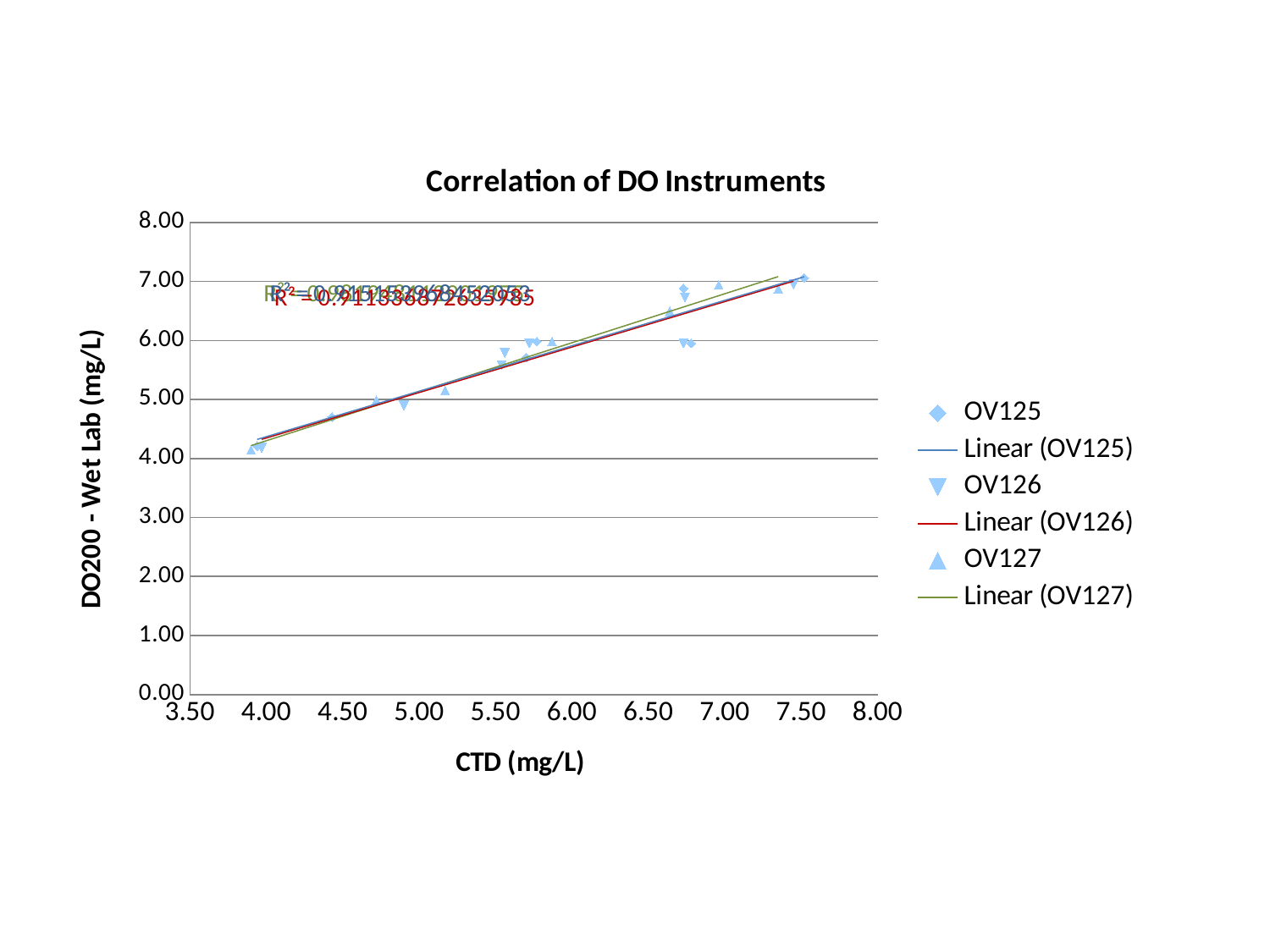
What kind of chart is shown on the slide? scatter chart How many scatter (point) series are plotted, excluding the linear trendlines? 3 Are the plotted DO200 - Wet Lab values near CTD 4.00 greater or less than 5.00? less What is the label of the vertical axis? DO200 - Wet Lab (mg/L) Are the plotted DO200 - Wet Lab values near CTD 5.00 greater or less than 4.00? greater Do the plotted values rise or fall as CTD (mg/L) increases along the x axis? rise How many entries does the legend list? 6 Are the plotted DO200 - Wet Lab values near CTD 7.50 greater or less than 6.00? greater What is the title of the chart? Correlation of DO Instruments